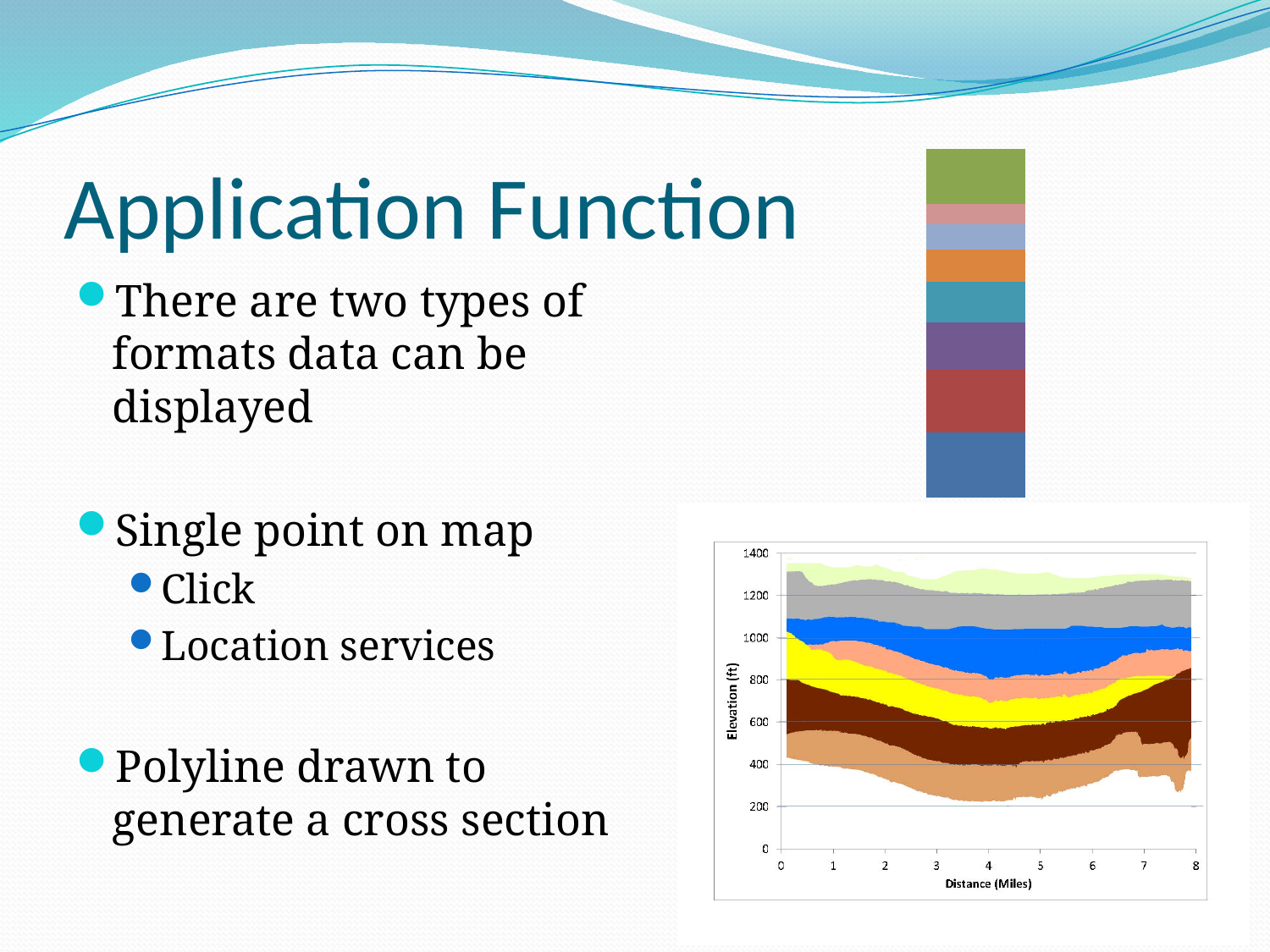
What is the title of the horizontal axis on the cross-section chart at the bottom right? Distance (Miles) On the cross-section chart, does the bottom of the lowest layer fall or rise as distance goes from 0 to 4 miles? fall What is the highest value shown on the vertical axis of the cross-section chart? 1400 How many colored layers are stacked in the cross-section chart? 7 On the cross-section chart, is the bottom of the lowest layer at distance 4 miles greater or less than 400 ft? less What is the largest distance value shown on the horizontal axis of the cross-section chart? 8 On the cross-section chart, is the top of the uppermost layer at distance 4 miles greater or less than 1400 ft? less On the cross-section chart, is the top of the uppermost layer at distance 0 miles greater or less than 1200 ft? greater How many colored segments make up the stacked bar in the upper right of the slide? 8 What kind of chart is the cross-section chart at the bottom right of the slide? stacked area chart What is the title of the vertical axis on the cross-section chart at the bottom right? Elevation (ft)